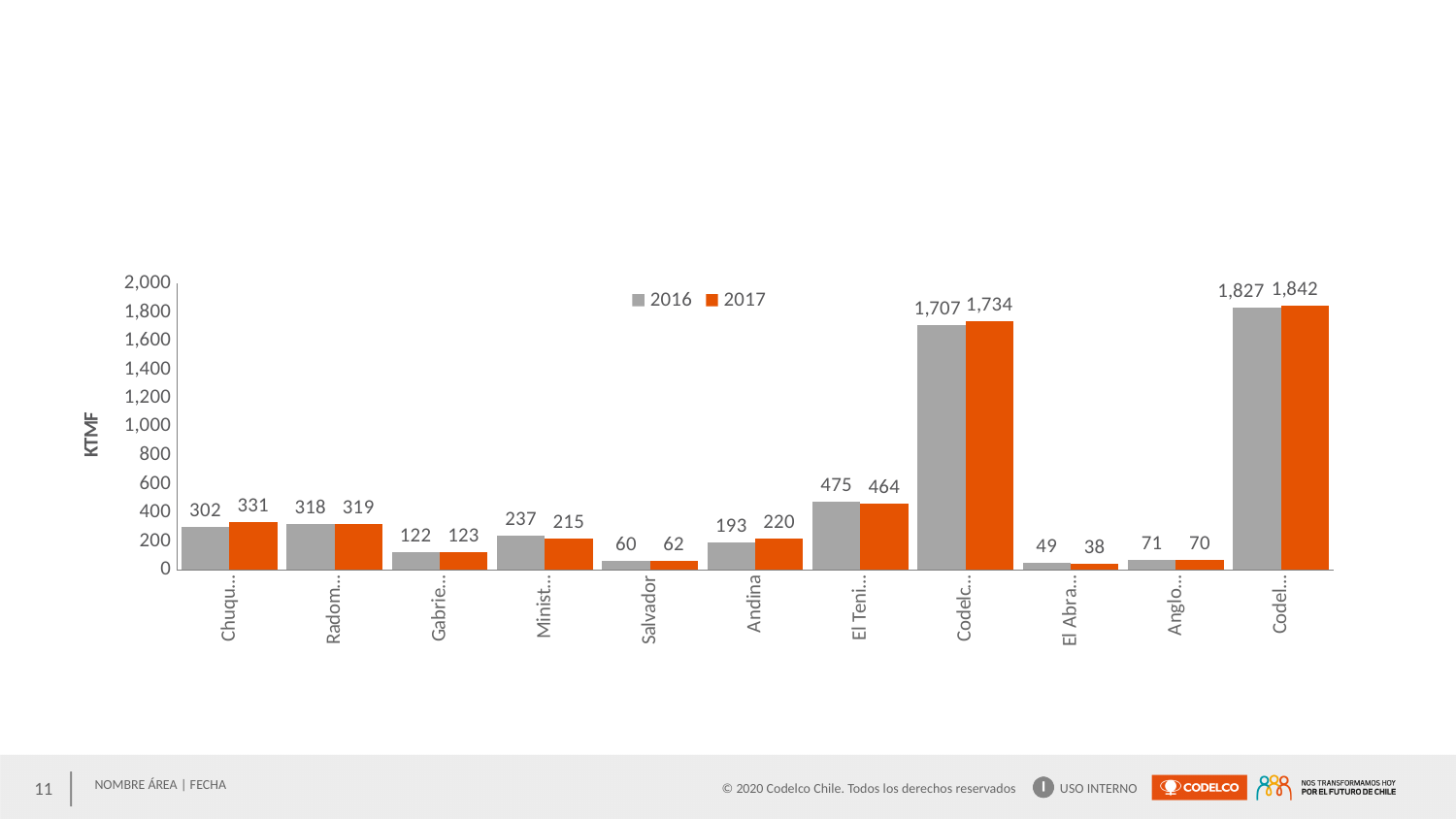
Which is larger for Salvador, the 2016 value or the 2017 value? 2017 What is the 2017 value for the category labelled "El Teni..."? 464 Which category has the lowest 2017 value? El Abra... What kind of chart is shown on the slide? Bar chart What is the 2016 value for the category labelled "Codel..." at the far right of the chart? 1,827 What is the label on the vertical axis? KTMF Which category has the highest 2016 value? Codel... (the rightmost category) What is the 2016 value for Andina? 193 What is the difference between the 2017 and 2016 values for Andina? 27 How many series does the legend list? 2 How many categories are shown on the x axis? 11 What is the 2017 value for Salvador? 62